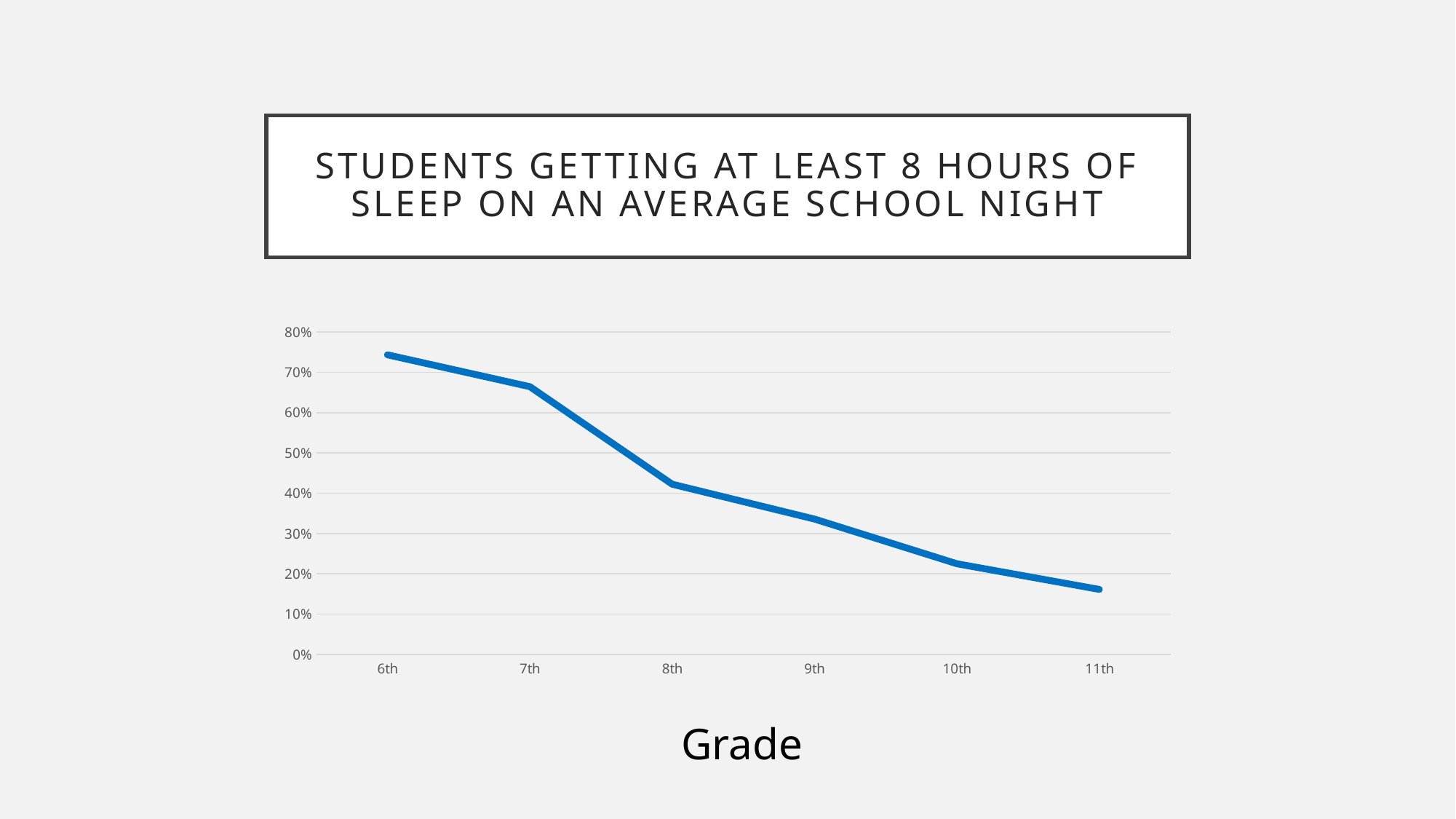
Which is larger, the value for 8th grade or the value for 10th grade? 8th Which grade has the highest percentage of students getting at least 8 hours of sleep? 6th Which grade has the lowest percentage of students getting at least 8 hours of sleep? 11th Is the value for 6th grade greater or less than 70%? greater Is the value for 9th grade greater or less than 40%? less Is the value for 7th grade greater or less than 70%? less What is the label of the x axis? Grade How many grades are plotted on the x axis? 6 Do the values rise or fall as grade increases from 6th to 11th? fall What kind of chart is shown on the slide? line chart